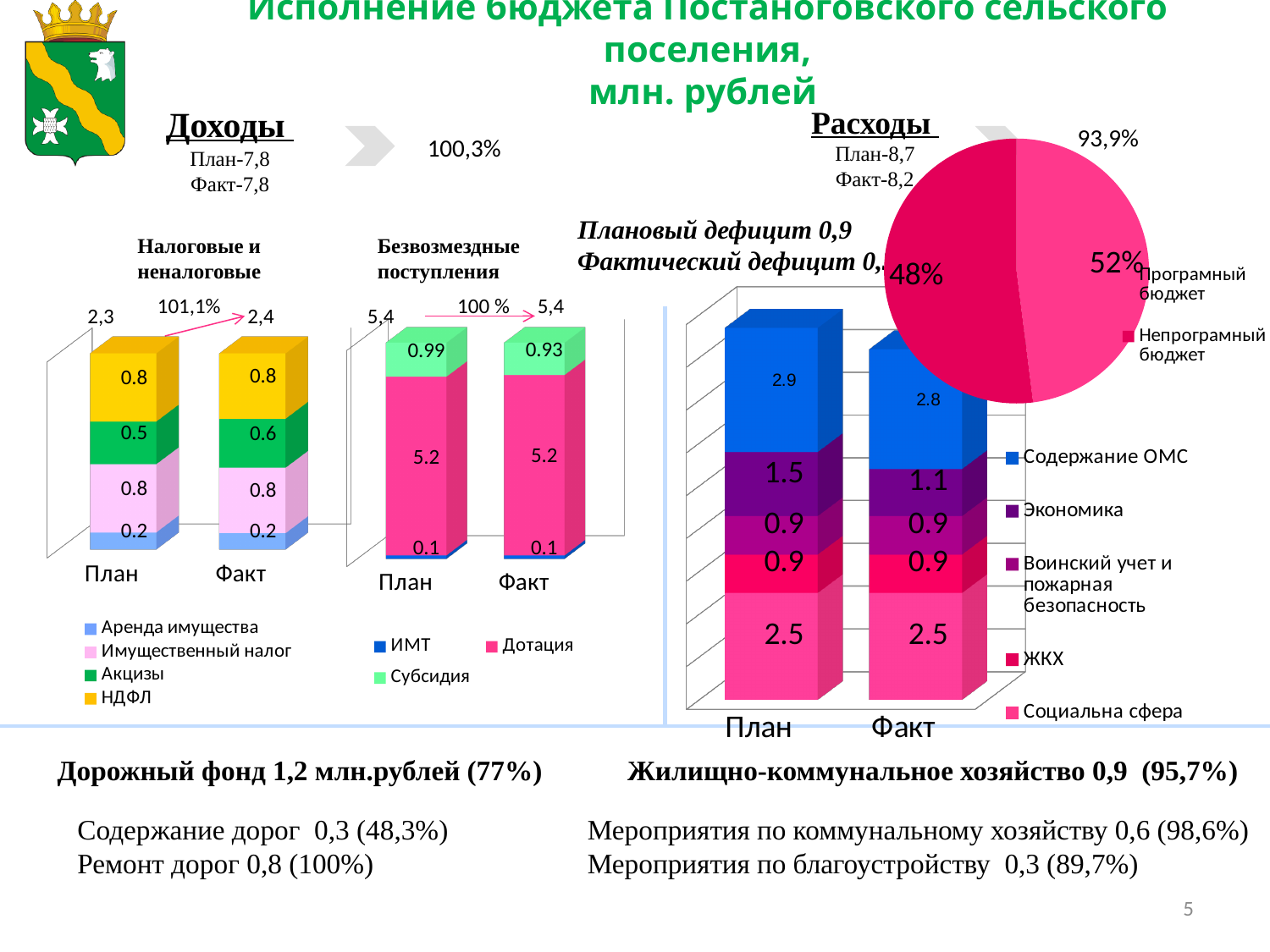
In the 'Налоговые и неналоговые' chart, how many series does the legend list? 4 In the Расходы bar chart, what is the difference between Содержание ОМС for План and for Факт? 0.1 In the Расходы bar chart, how many series does the legend list? 5 In the 'Безвозмездные поступления' chart, which series has the largest value in the План bar? Дотация In the 'Налоговые и неналоговые' chart, what is the value of Акцизы for Факт? 0.6 In the 'Налоговые и неналоговые' chart, what is the total of the План bar? 2,3 What kind of chart is the Расходы chart with План and Факт? Stacked bar chart In the 'Безвозмездные поступления' chart, what is the value of Субсидия for Факт? 0.93 In the 'Безвозмездные поступления' chart, what is the difference between Субсидия for План and Субсидия for Факт? 0.06 In the pie chart, what share does Програмный бюджет have? 52% In the pie chart, which slice is larger, Програмный бюджет or Непрограмный бюджет? Програмный бюджет In the Расходы bar chart, what is the value of Экономика for Факт? 1.1